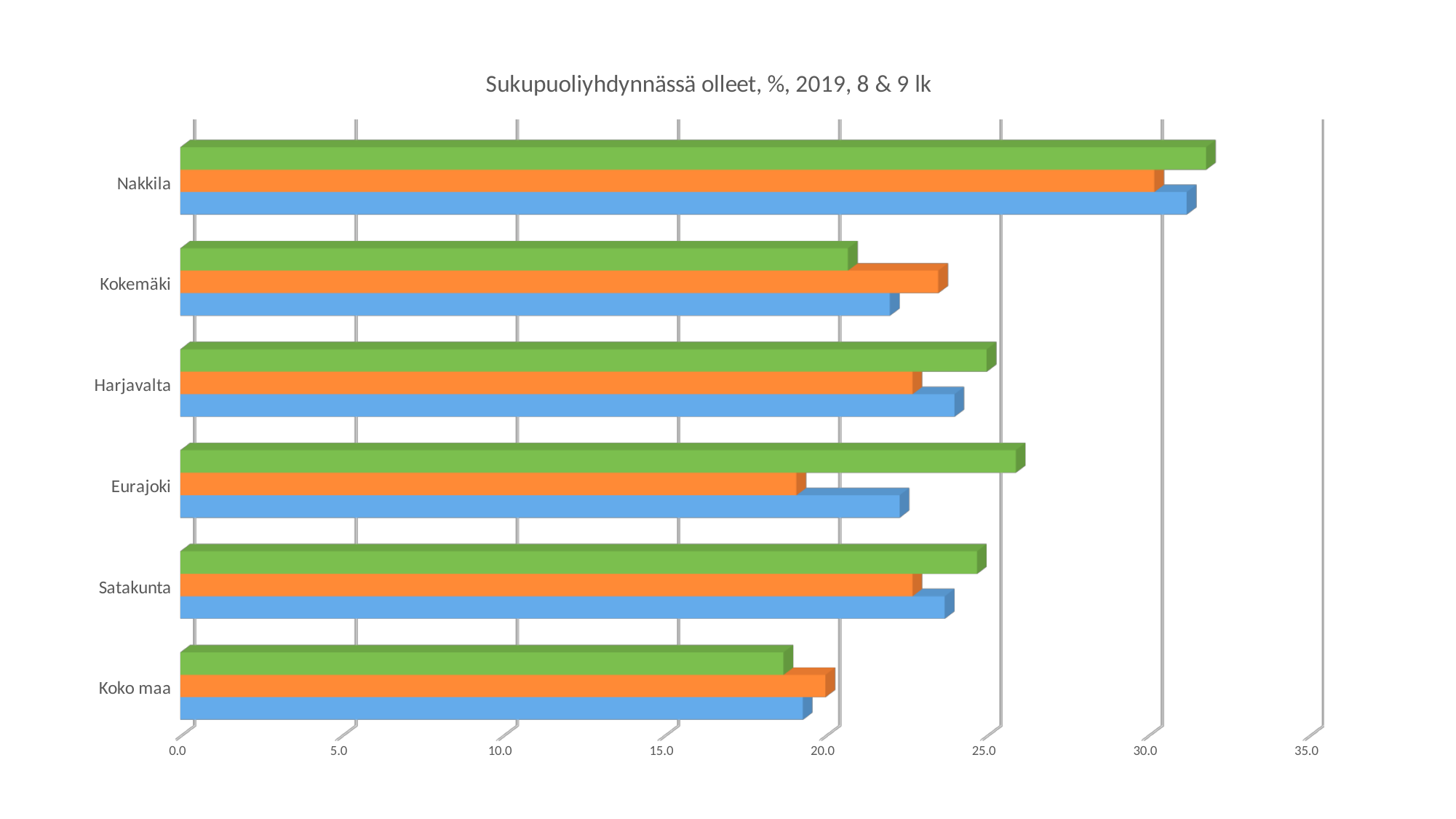
Which category has the longest green bar? Nakkila Which is larger, the orange bar for Kokemäki or the orange bar for Eurajoki? Kokemäki What is the title of the chart? Sukupuoliyhdynnässä olleet, %, 2019, 8 & 9 lk Which category has the longest blue bar? Nakkila Is the orange bar for Kokemäki greater or less than 20.0? greater Is the orange bar for Eurajoki greater or less than 20.0? less Which category has the shortest green bar? Koko maa Is the green bar for Nakkila greater or less than 30.0? greater What kind of chart is shown on the slide? bar chart How many bars are shown for each category in the chart? 3 How many categories are shown on the vertical axis of the chart? 6